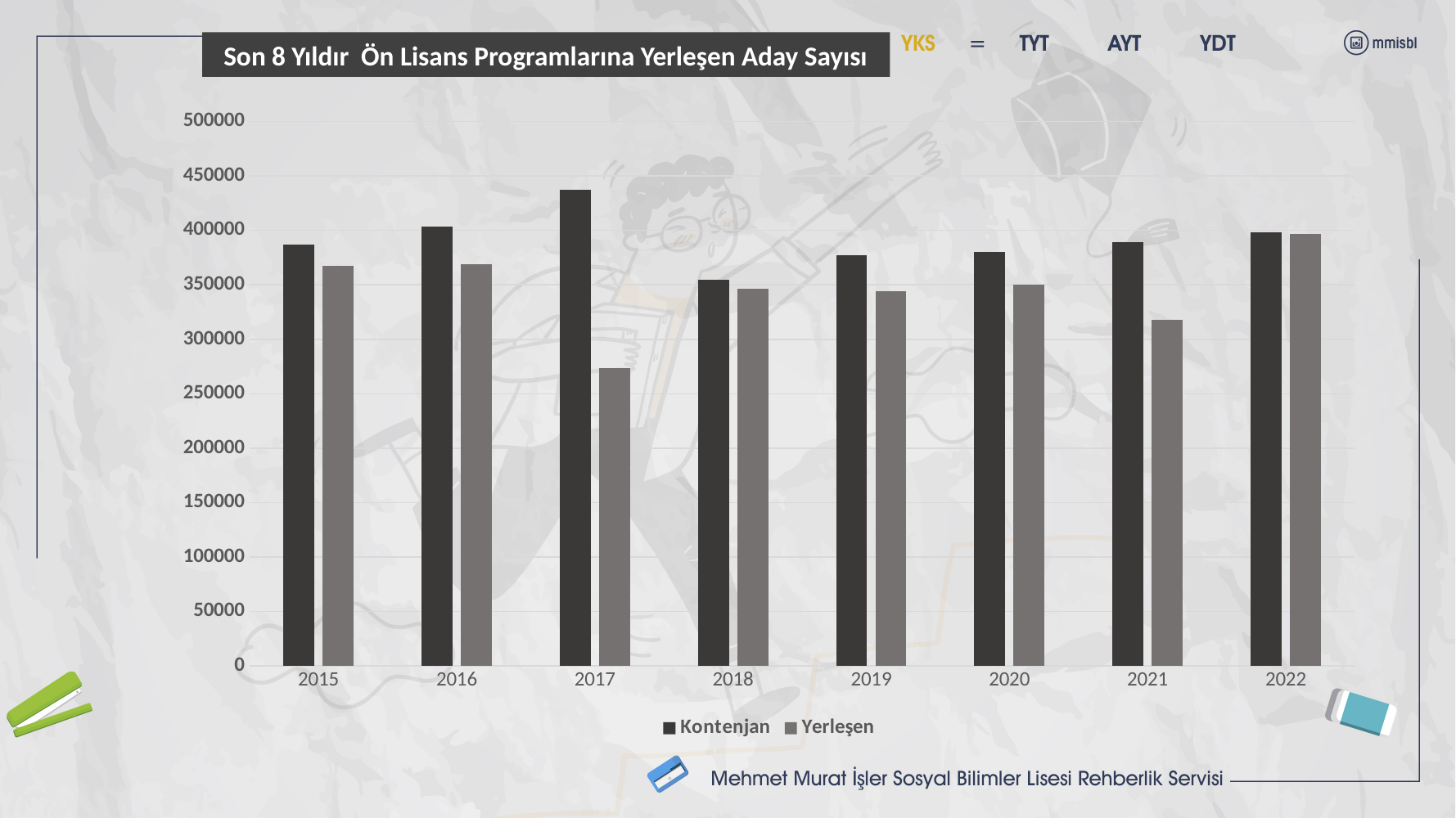
In 2021, which is larger, Kontenjan or Yerleşen? Kontenjan What is the title of the chart? Son 8 Yıldır Ön Lisans Programlarına Yerleşen Aday Sayısı In which year is the Kontenjan value highest? 2017 In which year is the Yerleşen value highest? 2022 How many years are shown on the x axis of the chart? 8 What kind of chart is shown on the slide? bar chart In which year is the Yerleşen value lowest? 2017 How many series does the chart's legend list? 2 Is the Kontenjan value for 2017 greater or less than 400000? greater What are the two series named in the legend? Kontenjan and Yerleşen Is the Yerleşen value for 2021 greater or less than 300000? greater Is the Yerleşen value for 2017 greater or less than 300000? less